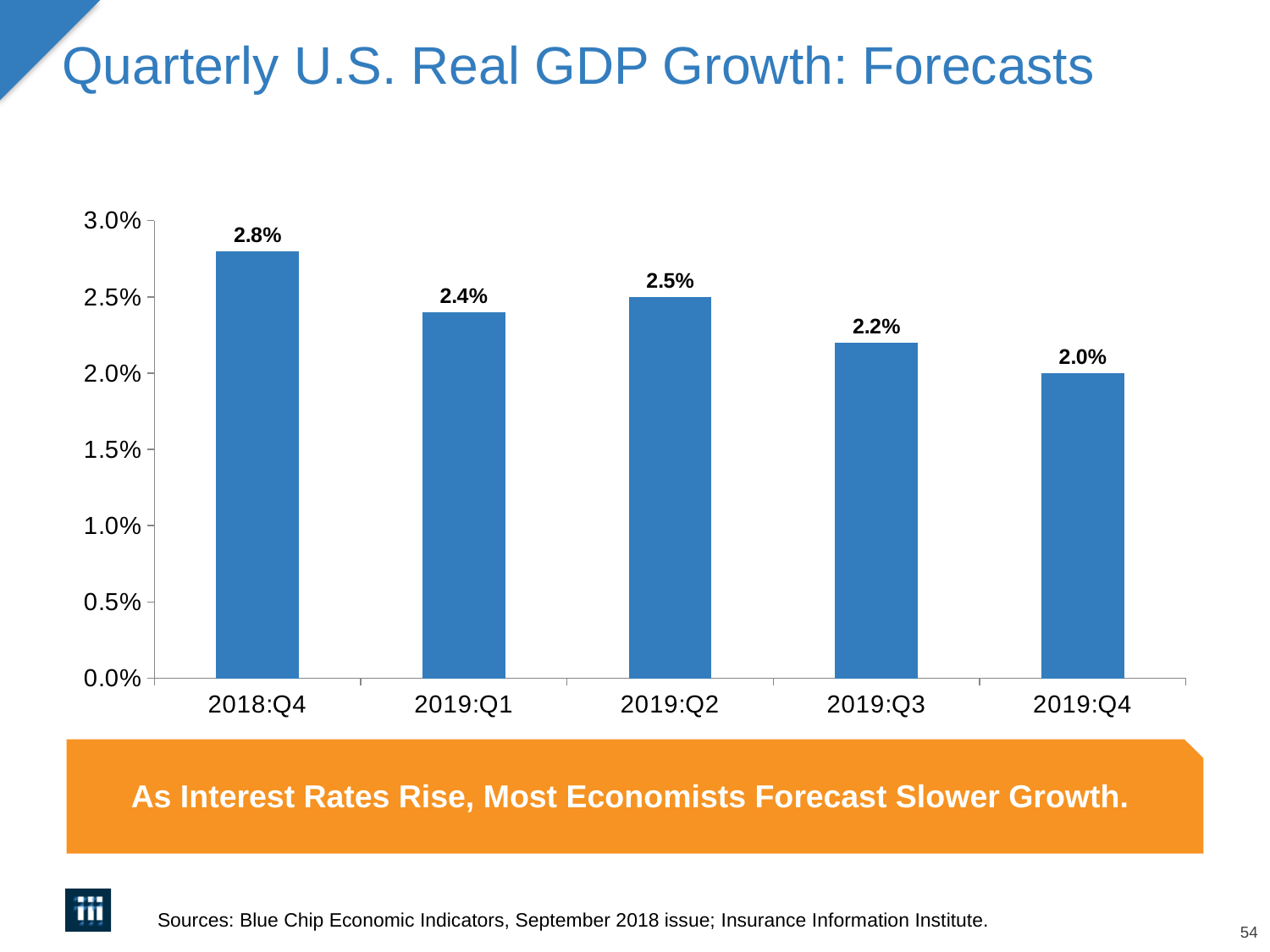
How many quarters are shown on the chart? 5 What kind of chart is shown on the slide? bar chart What is the difference between the forecast for 2018:Q4 and the forecast for 2019:Q4? 0.8% Which quarter has the lowest forecast GDP growth? 2019:Q4 Which is larger, the forecast for 2019:Q1 or the forecast for 2019:Q2? 2019:Q2 What is the forecast real GDP growth for 2018:Q4? 2.8% What is the title of the chart on the slide? Quarterly U.S. Real GDP Growth: Forecasts Is the value for 2019:Q3 greater or less than 2.5%? less What is the forecast real GDP growth for 2019:Q4? 2.0% What is the forecast real GDP growth for 2019:Q2? 2.5% What is the difference between the forecast for 2019:Q2 and the forecast for 2019:Q3? 0.3% Which quarter has the highest forecast GDP growth? 2018:Q4